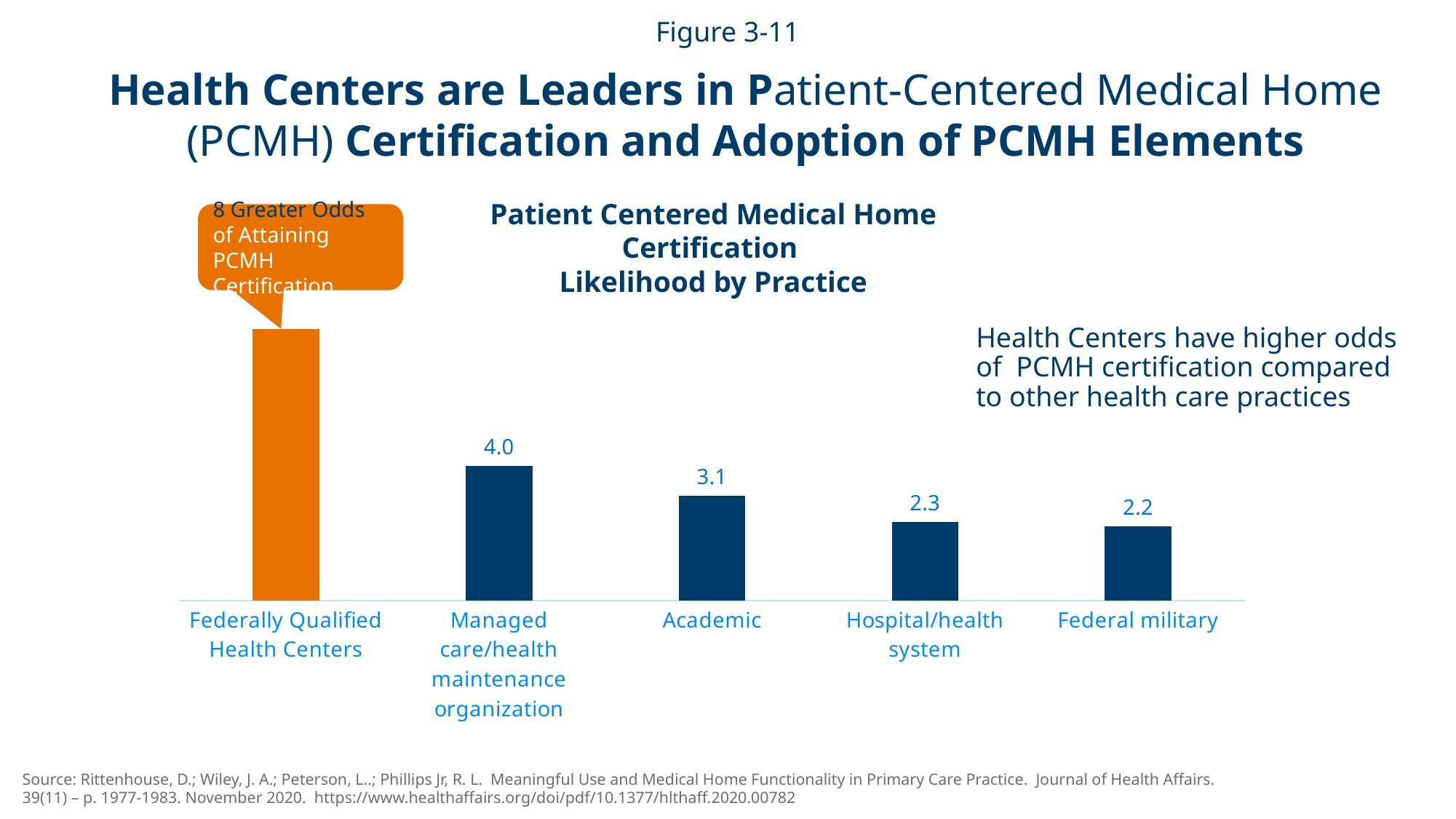
What kind of chart is shown on the slide? Bar chart What is the value for Managed care/health maintenance organization? 4.0 What is the difference between the values for Managed care/health maintenance organization and Academic? 0.9 What is the value for Academic? 3.1 Which is larger, the value for Academic or the value for Hospital/health system? Academic Which category has the highest bar? Federally Qualified Health Centers According to the callout, how many times greater are the odds of attaining PCMH certification for Federally Qualified Health Centers? 8 Which category has the lowest value? Federal military What is the difference between the values for Hospital/health system and Federal military? 0.1 What is the value for Hospital/health system? 2.3 What is the value for Federal military? 2.2 How many categories are shown in the chart? 5